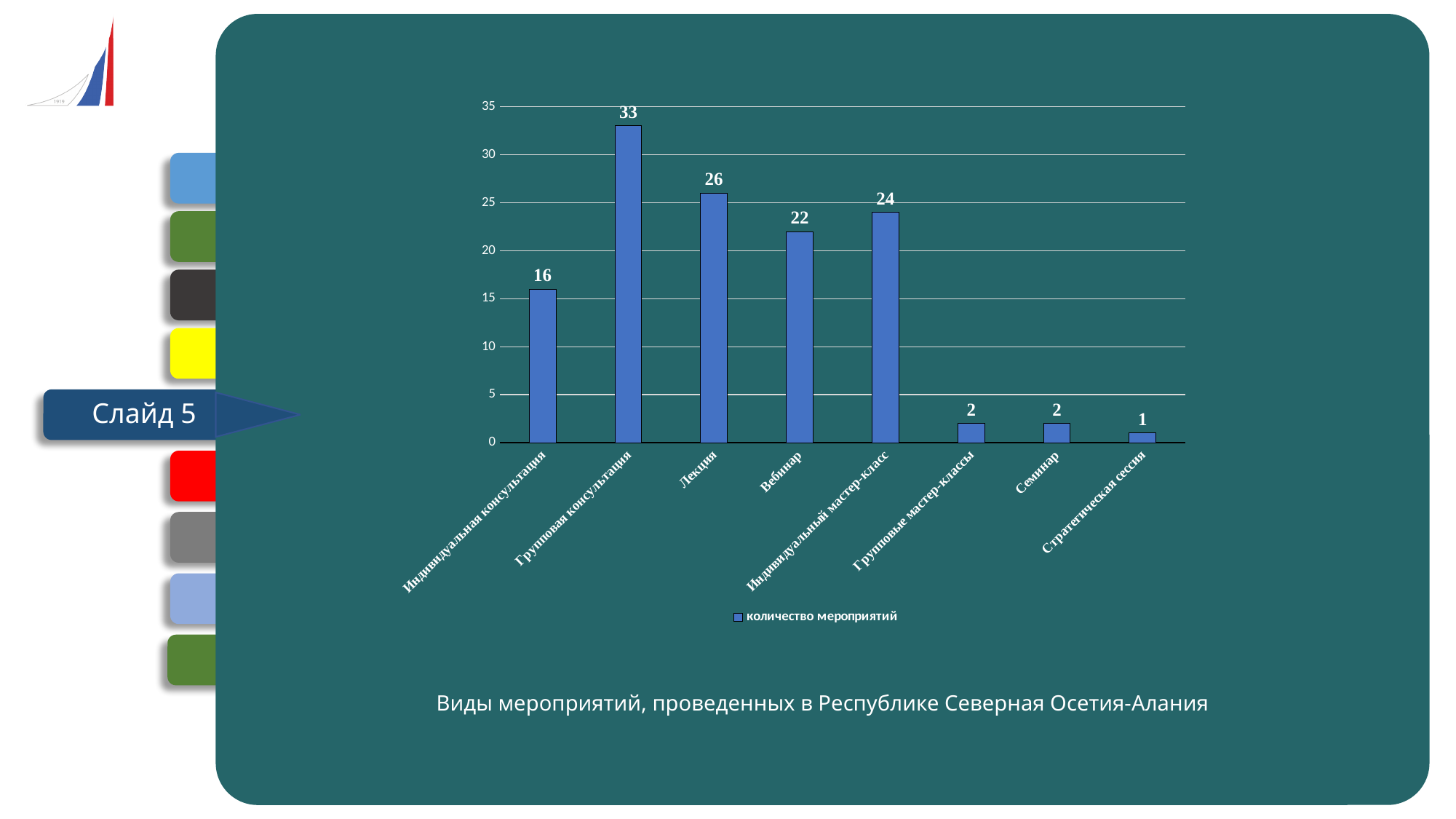
What is the value for Вебинар? 22 Is the value for Лекция greater or less than 25? greater Which category has the lowest value? Стратегическая сессия What kind of chart is shown on the slide? bar chart How many categories are shown on the x axis? 8 What is the difference between the values for Групповая консультация and Лекция? 7 What is the legend entry for the series? количество мероприятий Which is larger, the value for Индивидуальная консультация or the value for Вебинар? Вебинар How many series does the legend list? 1 What is the value for Групповая консультация? 33 What is the value for Индивидуальный мастер-класс? 24 Which category has the highest value? Групповая консультация